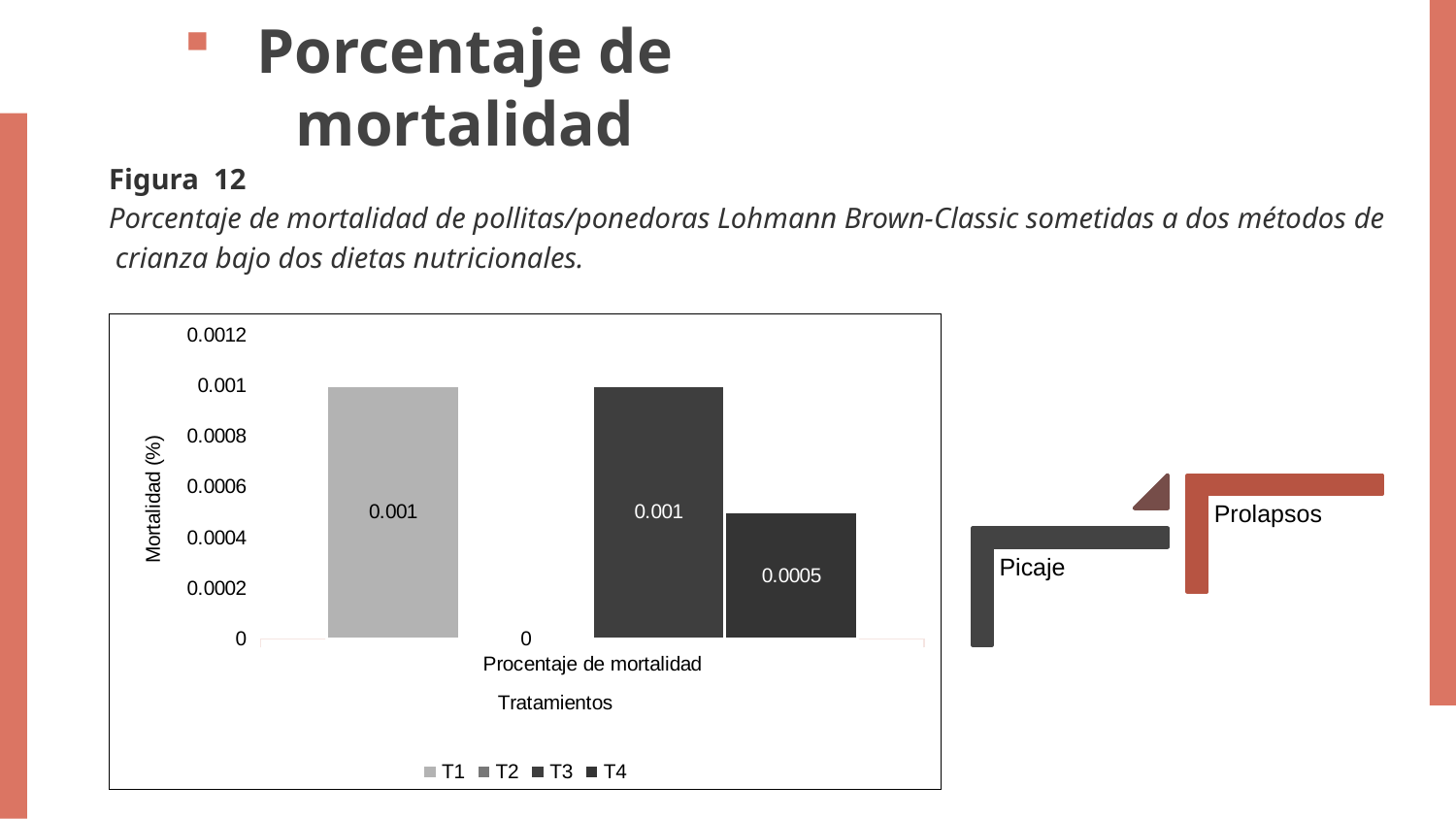
Which is larger, the value for T1 or the value for T4? T1 How many series does the legend list? 4 What is the difference between the values for T3 and T4? 0.0005 Which series has the lowest value? T2 What is the value for T1? 0.001 What type of chart is shown on the slide? bar chart What is the label of the horizontal axis? Tratamientos Is the value for T4 greater or less than 0.0008? less What is the value for T2? 0 What is the value for T4? 0.0005 What is the label of the vertical axis? Mortalidad (%) What is the value for T3? 0.001